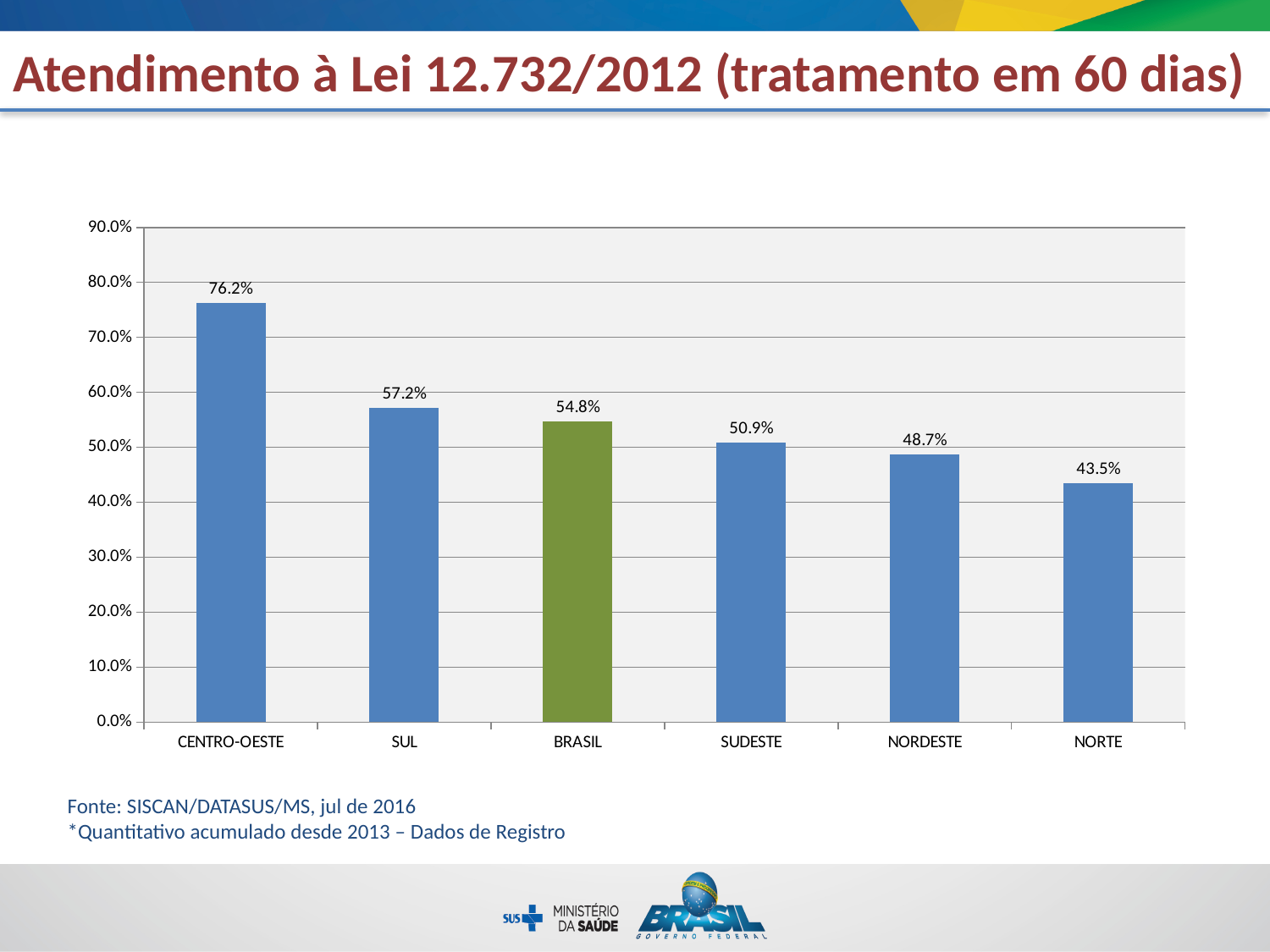
What is the value for NORTE? 43.5% Is the value for NORDESTE greater or less than 50.0%? less What kind of chart is shown on the slide? bar chart Which category has the lowest value? NORTE What is the difference between the values for CENTRO-OESTE and SUL? 19.0% What is the difference between the values for SUDESTE and NORDESTE? 2.2% How many categories are shown on the x axis? 6 Which is larger, the value for SUL or the value for SUDESTE? SUL What is the value for CENTRO-OESTE? 76.2% Which category has the highest value? CENTRO-OESTE What is the value for BRASIL? 54.8% Which bar is coloured green rather than blue? BRASIL